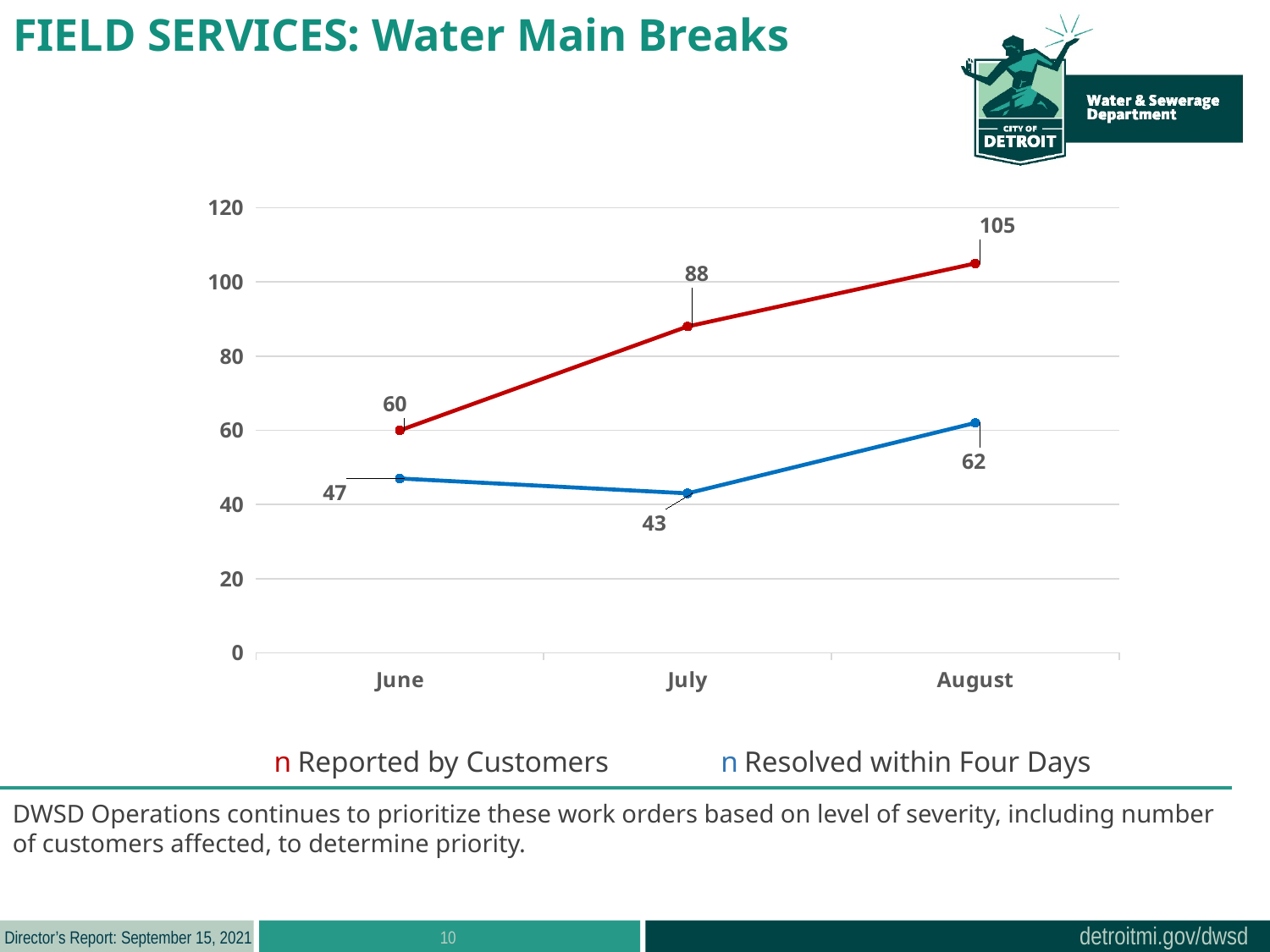
How many series does the legend list? 2 What is the value for Reported by Customers in July? 88 What is the value for Reported by Customers in August? 105 How many months are plotted on the x axis? 3 Does the Reported by Customers series rise or fall from June to August? rise What is the value for Resolved within Four Days in June? 47 Which is larger in June: Reported by Customers or Resolved within Four Days? Reported by Customers In which month is Resolved within Four Days lowest? July What colour is the line for Resolved within Four Days? blue In which month is Reported by Customers highest? August What kind of chart is shown on the slide? line chart What is the difference between Reported by Customers and Resolved within Four Days in August? 43